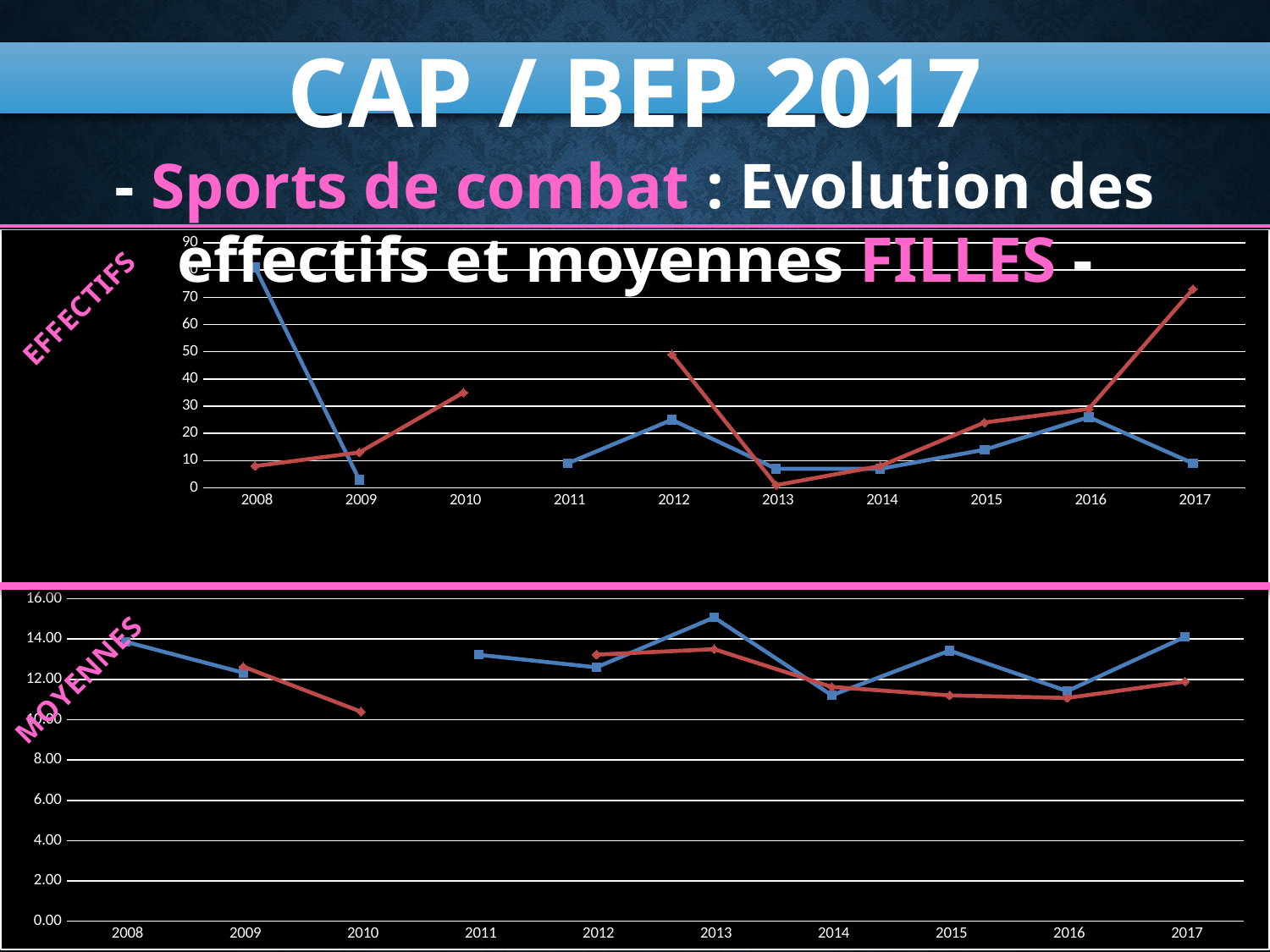
In the top chart (EFFECTIFS), is the value of the blue line for 2009 greater or less than 10? less In the top chart (EFFECTIFS), does the red line rise or fall from 2014 to 2017? rise What kind of chart is the top chart labelled EFFECTIFS? line chart In the top chart (EFFECTIFS), is the value of the blue line for 2008 greater or less than 70? greater In the top chart (EFFECTIFS), is the value of the red line for 2017 greater or less than 60? greater In the top chart (EFFECTIFS), for 2017, which line has the larger value, the red line or the blue line? the red line How many charts are shown on the slide? 2 How many years are shown on the x axis of the top chart (EFFECTIFS)? 10 In the top chart (EFFECTIFS), in which year does the red line reach its highest value? 2017 In the top chart (EFFECTIFS), in which year does the blue line reach its highest value? 2008